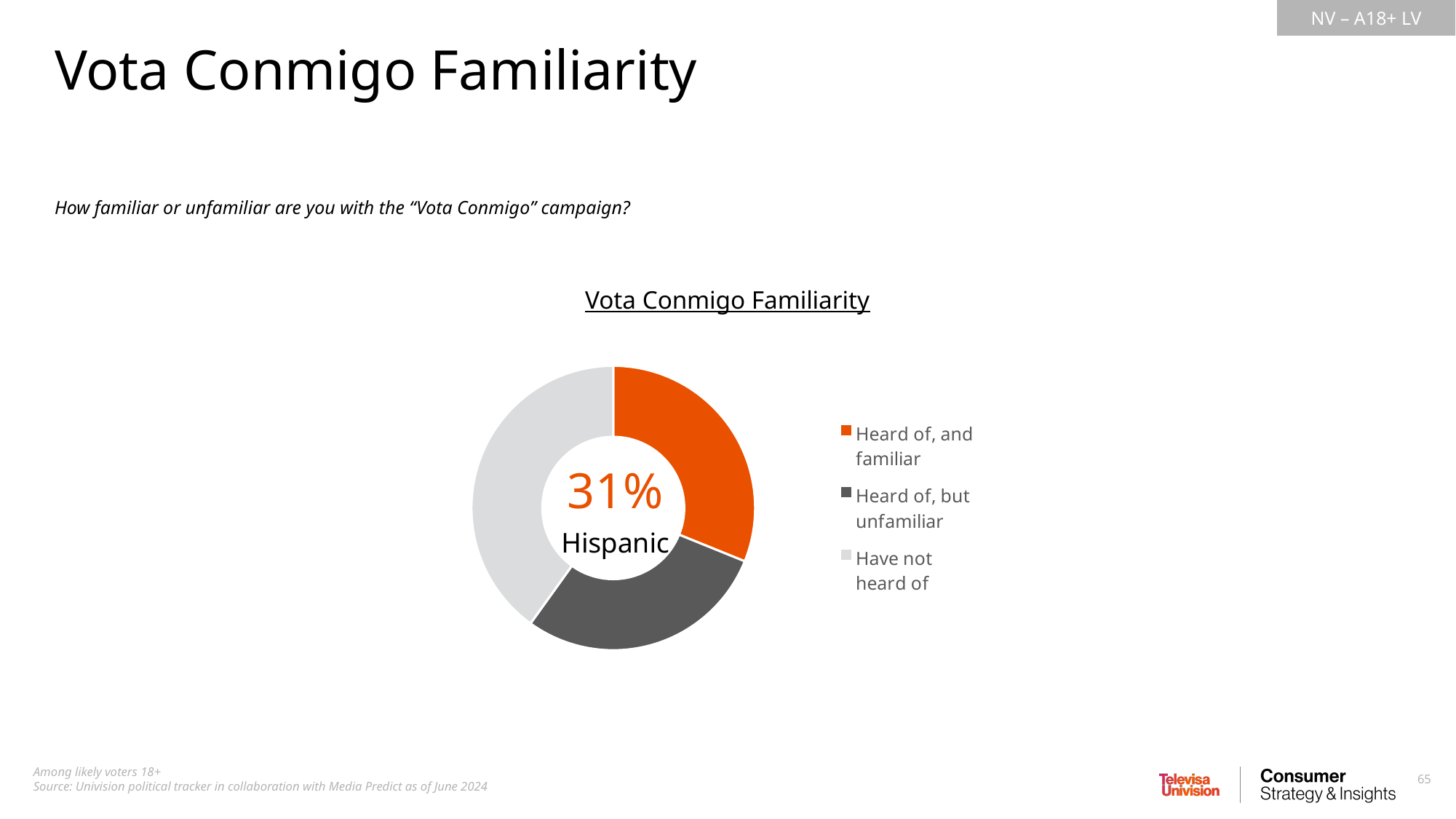
What percentage is printed in the centre of the donut chart? 31% What share of Hispanic likely voters have heard of, and are familiar with, the Vota Conmigo campaign? 31% What is the title of the chart? Vota Conmigo Familiarity Which legend entry is shown in orange? Heard of, and familiar Which group does the chart describe, according to the label in the centre of the donut? Hispanic What kind of chart is shown on the slide? Pie chart (donut) Which category has the largest slice of the donut chart? Have not heard of How many categories does the chart's legend list? 3 Which slice is larger: 'Have not heard of' or 'Heard of, and familiar'? Have not heard of